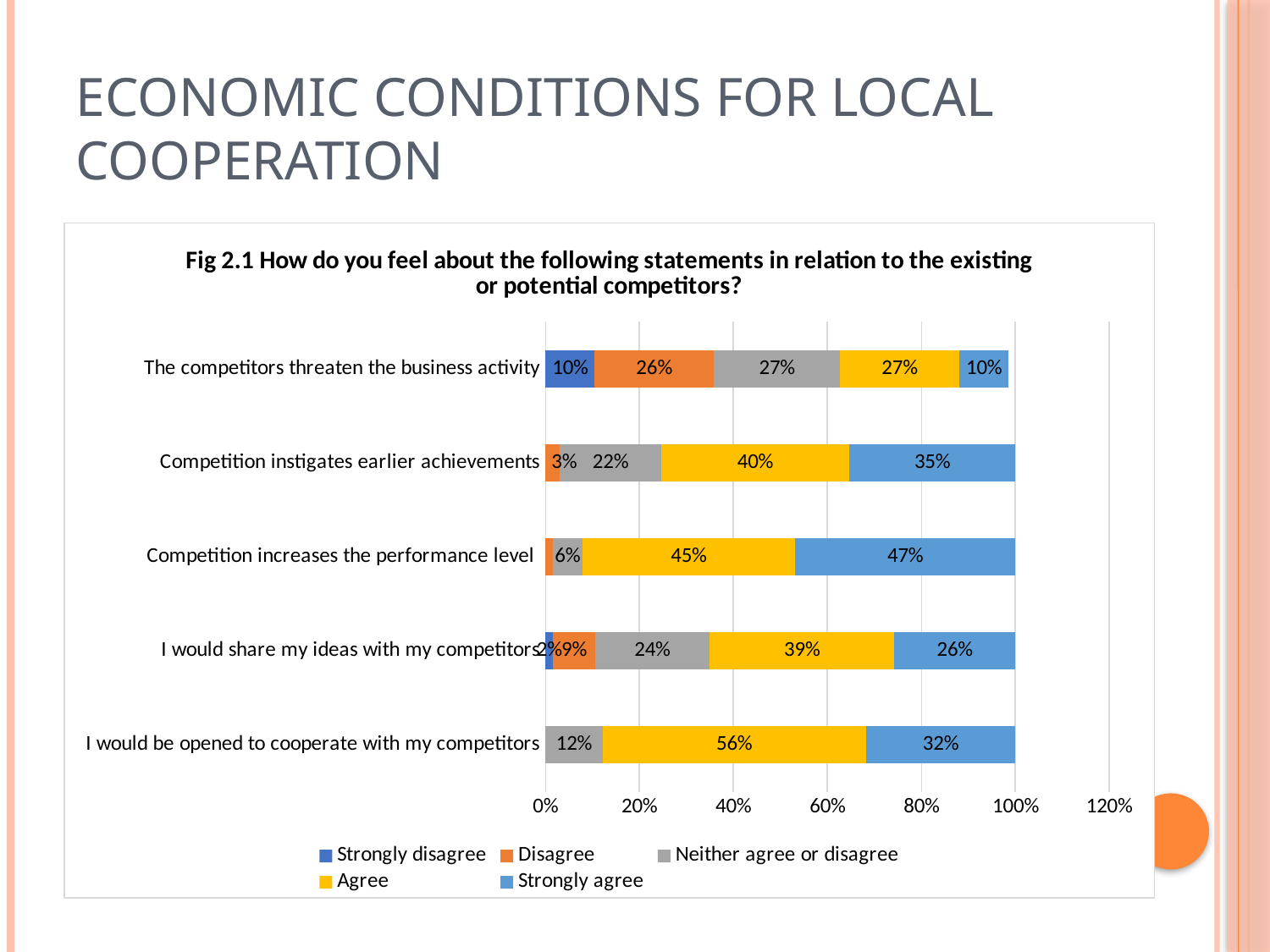
What is the 'Strongly agree' value for 'Competition increases the performance level'? 47% What percentage of respondents 'Agree' with the statement 'I would be opened to cooperate with my competitors'? 56% Which has a larger 'Strongly agree' share: 'Competition instigates earlier achievements' or 'I would be opened to cooperate with my competitors'? Competition instigates earlier achievements What kind of chart is shown on the slide? Stacked bar chart For 'Competition instigates earlier achievements', how much larger is the 'Agree' share than the 'Strongly agree' share? 5 percentage points How many series does the legend list? 5 How many statements (categories) are plotted in the chart? 5 Which statement has the highest 'Strongly agree' share? Competition increases the performance level What is the 'Disagree' value for 'The competitors threaten the business activity'? 26% What is the 'Neither agree or disagree' value for 'I would share my ideas with my competitors'? 24% Which statement has the highest 'Agree' share? I would be opened to cooperate with my competitors What is the title of the chart? Fig 2.1 How do you feel about the following statements in relation to the existing or potential competitors?